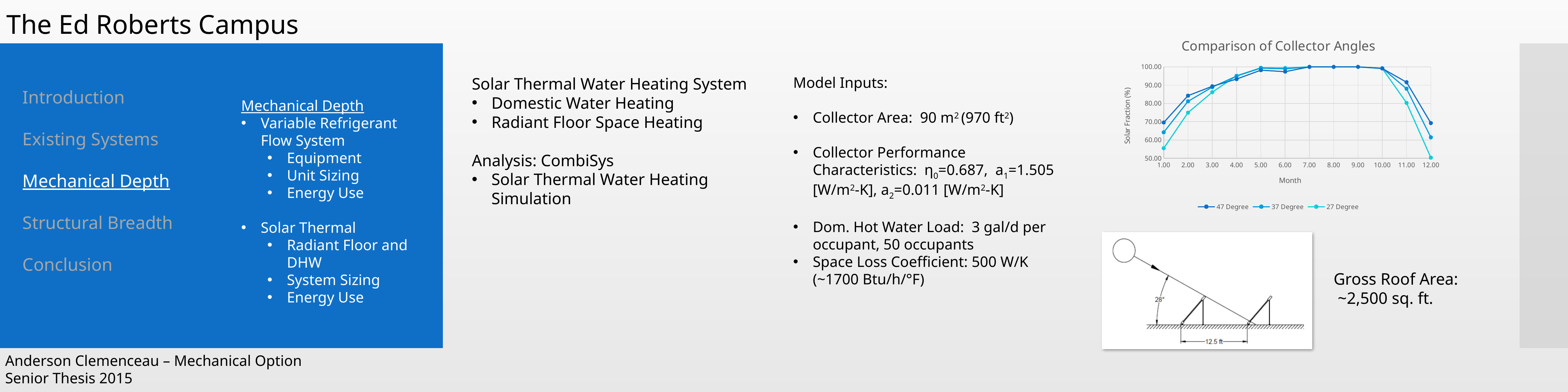
How many series does the legend of the 'Comparison of Collector Angles' chart list? 3 In the 'Comparison of Collector Angles' chart, is the 27 Degree value at month 12.00 greater or less than 60.00? less In the 'Comparison of Collector Angles' chart, which series has the lowest value at month 12.00? 27 Degree What kind of chart is 'Comparison of Collector Angles'? line chart What are the three series named in the legend of the 'Comparison of Collector Angles' chart? 47 Degree, 37 Degree, 27 Degree In the 'Comparison of Collector Angles' chart, is the 47 Degree value at month 12.00 greater or less than 60.00? greater In the 'Comparison of Collector Angles' chart, do the 47 Degree values rise or fall from month 1.00 to month 5.00? rise What is the label of the y axis in the 'Comparison of Collector Angles' chart? Solar Fraction (%) In the 'Comparison of Collector Angles' chart, do the 27 Degree values rise or fall from month 10.00 to month 12.00? fall How many months are plotted along the x axis of the 'Comparison of Collector Angles' chart? 12 In the 'Comparison of Collector Angles' chart, which series has the higher value at month 1.00, 47 Degree or 27 Degree? 47 Degree In the 'Comparison of Collector Angles' chart, is the 27 Degree value at month 1.00 greater or less than 60.00? less